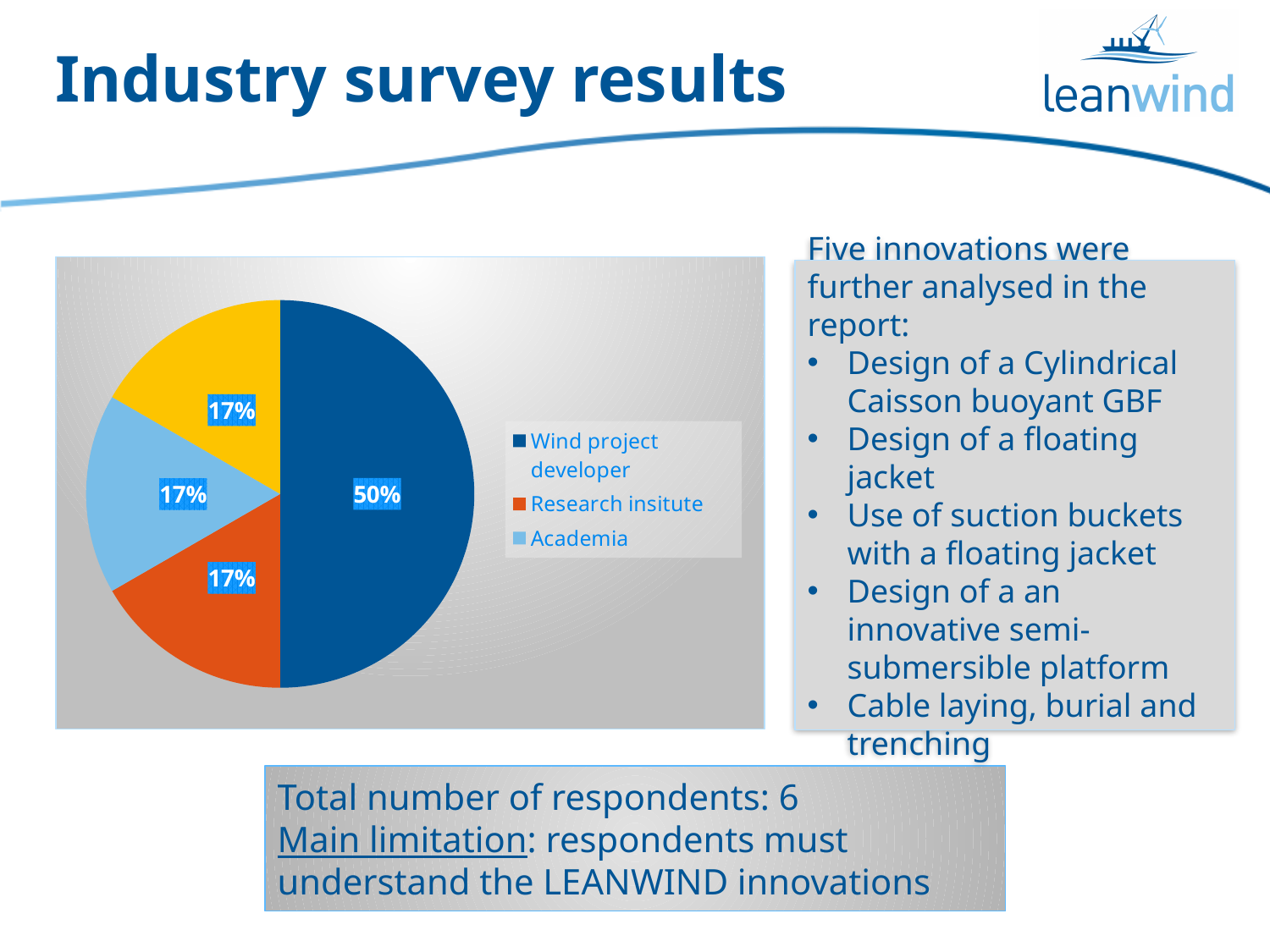
What colour is the Academia slice? light blue What is the difference in percentage points between Wind project developer and Research insitute? 33% Which is larger, the share for Wind project developer or the share for Academia? Wind project developer What percentage is shown for Research insitute? 17% What percentage is shown for Academia? 17% What colour is the Wind project developer slice? dark blue What kind of chart is shown on the slide? pie chart Which category has the largest slice of the pie? Wind project developer What share of the pie does Wind project developer account for? 50% How many slices does the pie chart have? 4 How many entries does the legend list? 3